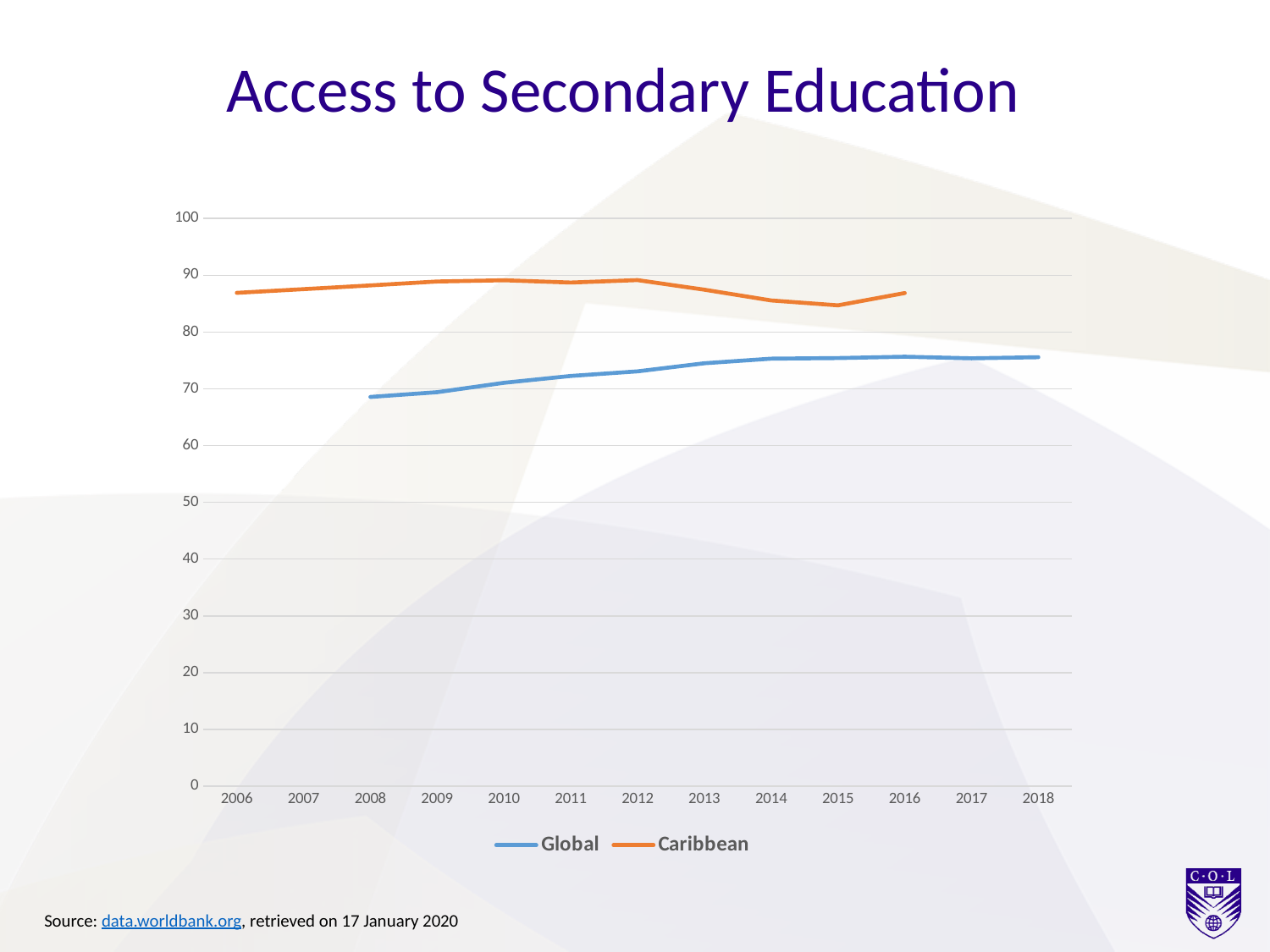
Does the Global series generally rise or fall from 2008 to 2018? rise Is the value for Global in 2008 greater or less than 70? less In 2012, which series has the larger value, Global or Caribbean? Caribbean How many years are labelled on the x axis? 13 In which year is the Caribbean series at its lowest? 2015 What is the title of the chart? Access to Secondary Education Is the value for Caribbean in 2015 greater or less than 80? greater How many series does the legend list? 2 Is the value for Caribbean in 2006 greater or less than 90? less In which year is the Global series at its lowest? 2008 What kind of chart is shown on the slide? line chart